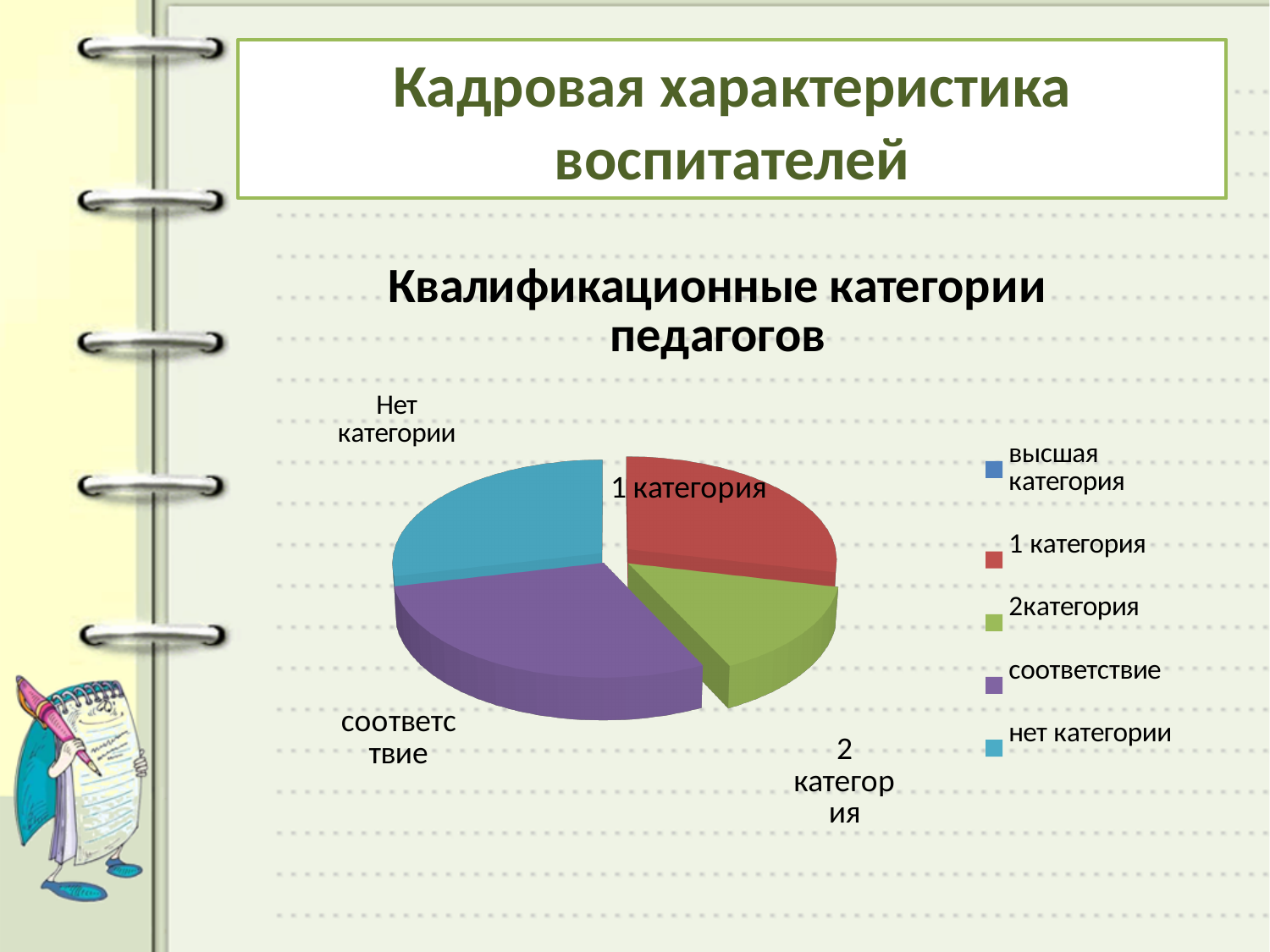
What kind of chart is shown on the slide? pie chart How many slices are visible in the pie chart? 4 Which of the visible slices is the smallest? 2 категория Which slice is larger: 1 категория or 2 категория? 1 категория How many entries does the chart's legend list? 5 Which legend entry has no visible slice in the pie? высшая категория What is the title of the chart? Квалификационные категории педагогов Which slice is larger: соответствие or 2 категория? соответствие